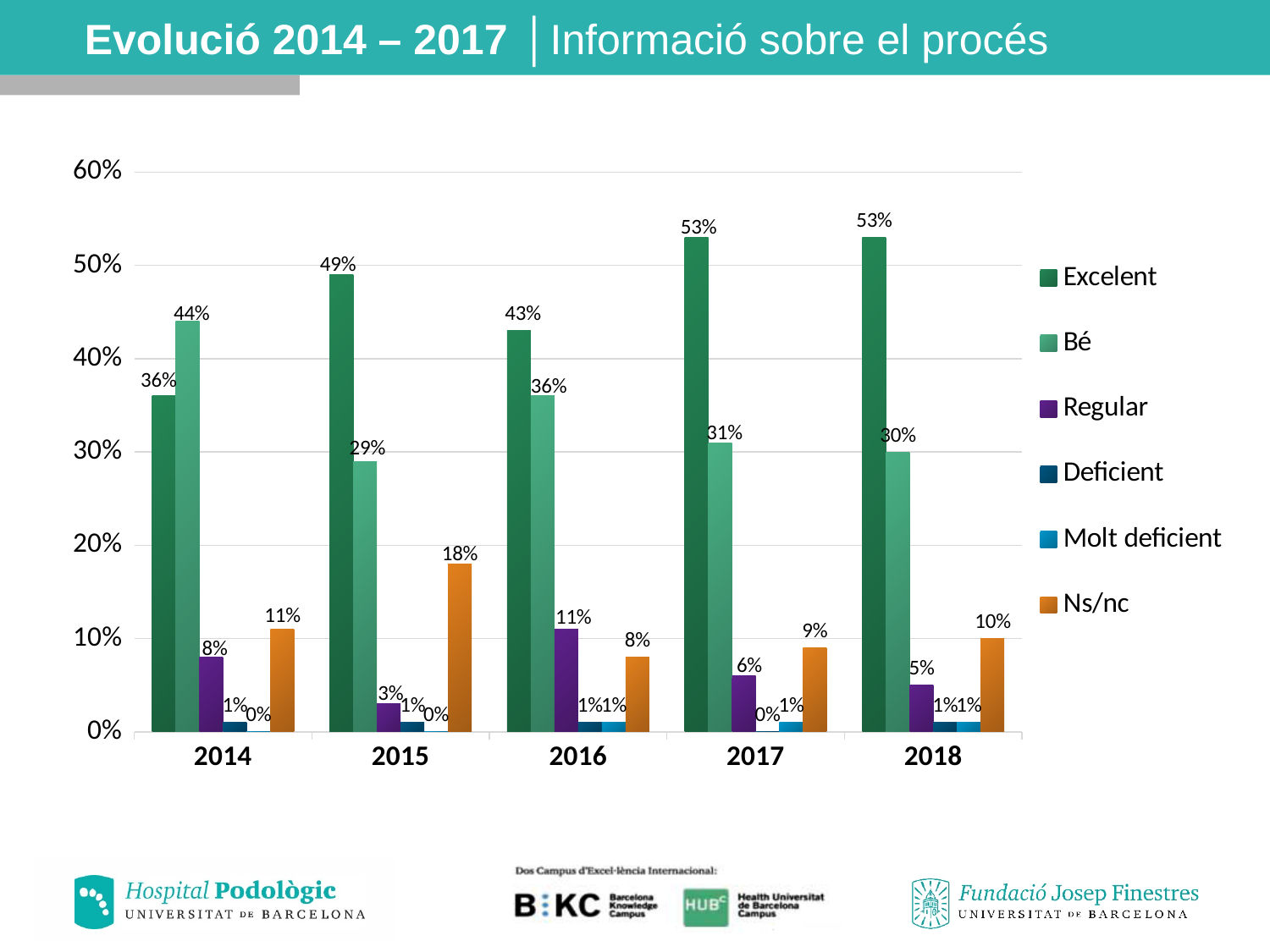
Does the Bé value rise or fall from 2016 to 2018? Fall What is the value for Regular in 2016? 11% In which year is the Excelent value lowest? 2014 How many series does the legend list? 6 Which is larger in 2014, Excelent or Bé? Bé In which year is the Ns/nc value highest? 2015 What is the value for Excelent in 2015? 49% What kind of chart is shown on the slide? Bar chart What is the difference between the Excelent and Bé values in 2017? 22% What is the value for Ns/nc in 2015? 18% What is the value for Bé in 2014? 44% How many years are shown on the x axis? 5